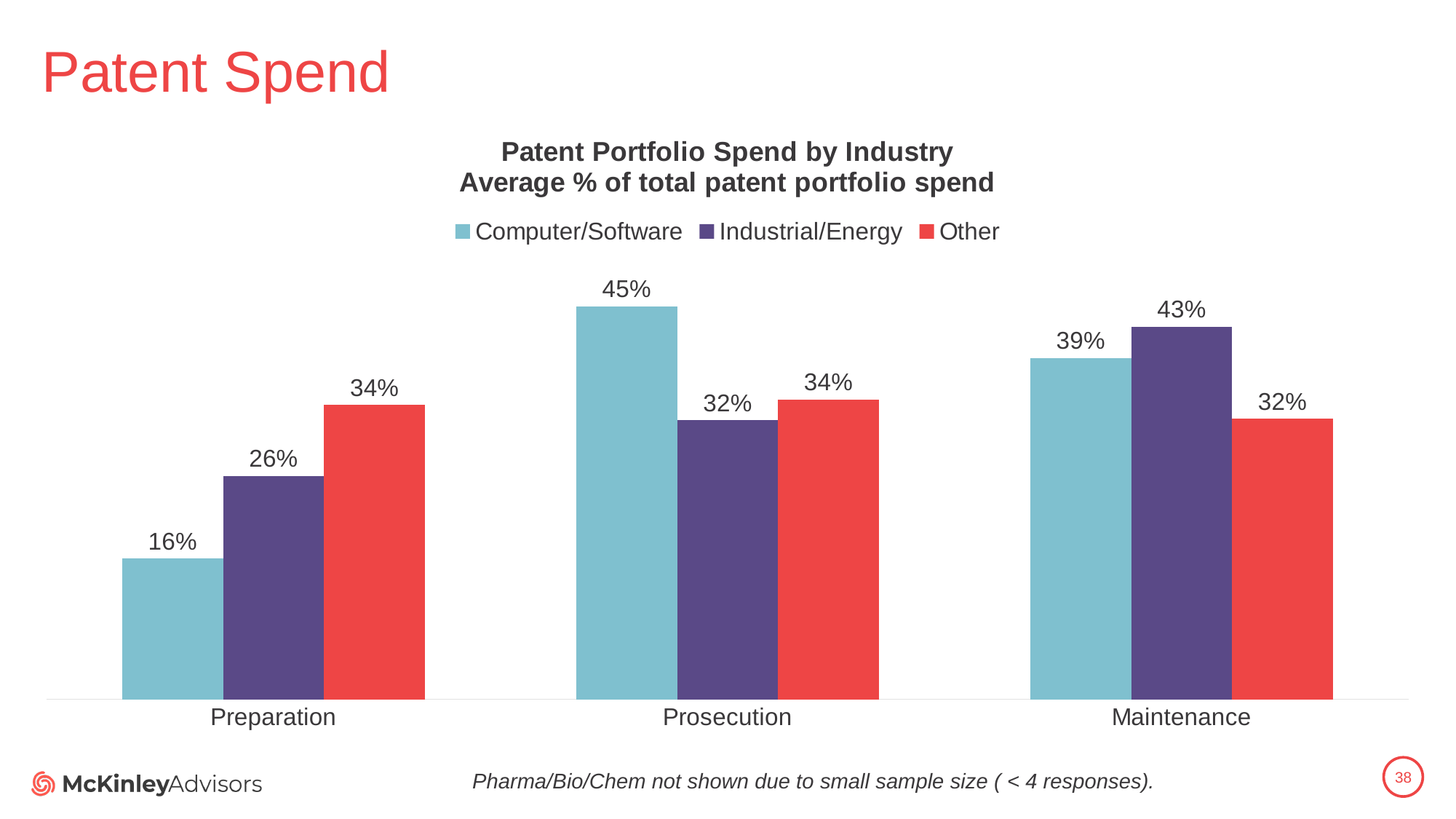
Which category has the lowest Industrial/Energy value? Preparation Do the Computer/Software values rise or fall from Preparation to Prosecution? Rise What kind of chart is shown? Bar chart How many series does the legend list? 3 What is the Industrial/Energy value for Maintenance? 43% What is the Other value for Prosecution? 34% What is the difference between the Computer/Software and Industrial/Energy values for Prosecution? 13% Which category has the highest Computer/Software value? Prosecution What is the title of the chart? Patent Portfolio Spend by Industry Which is larger for Preparation: the Industrial/Energy value or the Other value? Other How many categories are shown on the x axis? 3 What is the Computer/Software value for Preparation? 16%